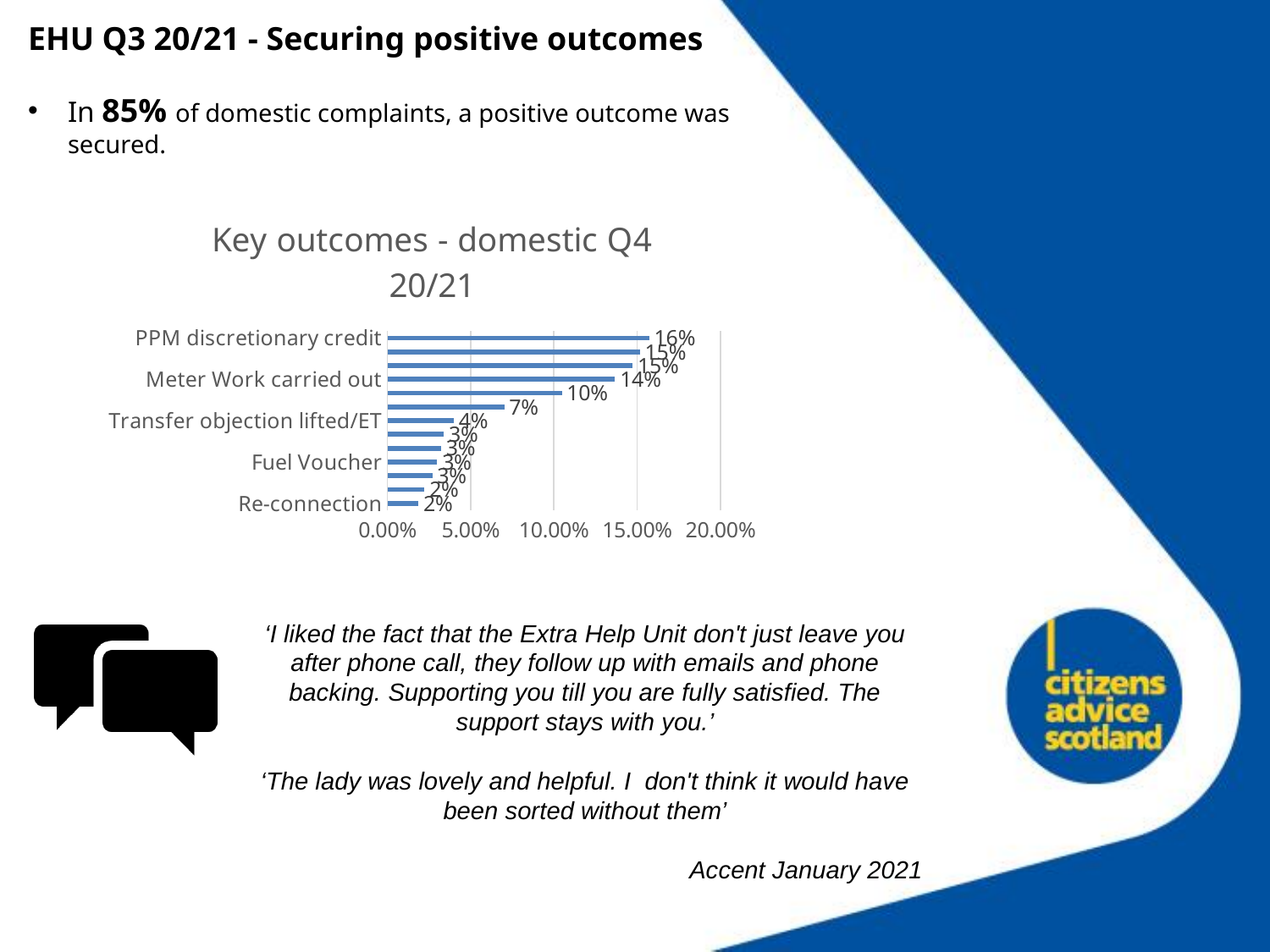
What is the value for PPM discretionary credit? 16% What is the value for Fuel Voucher? 3% What is the title of the chart? Key outcomes - domestic Q4 20/21 What is the value for Re-connection? 2% Is the value for Meter Work carried out greater or less than 10.00%? greater Which labelled category has the highest value? PPM discretionary credit What is the value for Meter Work carried out? 14% What kind of chart is shown on the slide? bar chart What is the value for Transfer objection lifted/ET? 4% What is the difference between the values for PPM discretionary credit and Meter Work carried out? 2% Which is larger, the value for Meter Work carried out or the value for Transfer objection lifted/ET? Meter Work carried out Is the value for Fuel Voucher greater or less than 5.00%? less